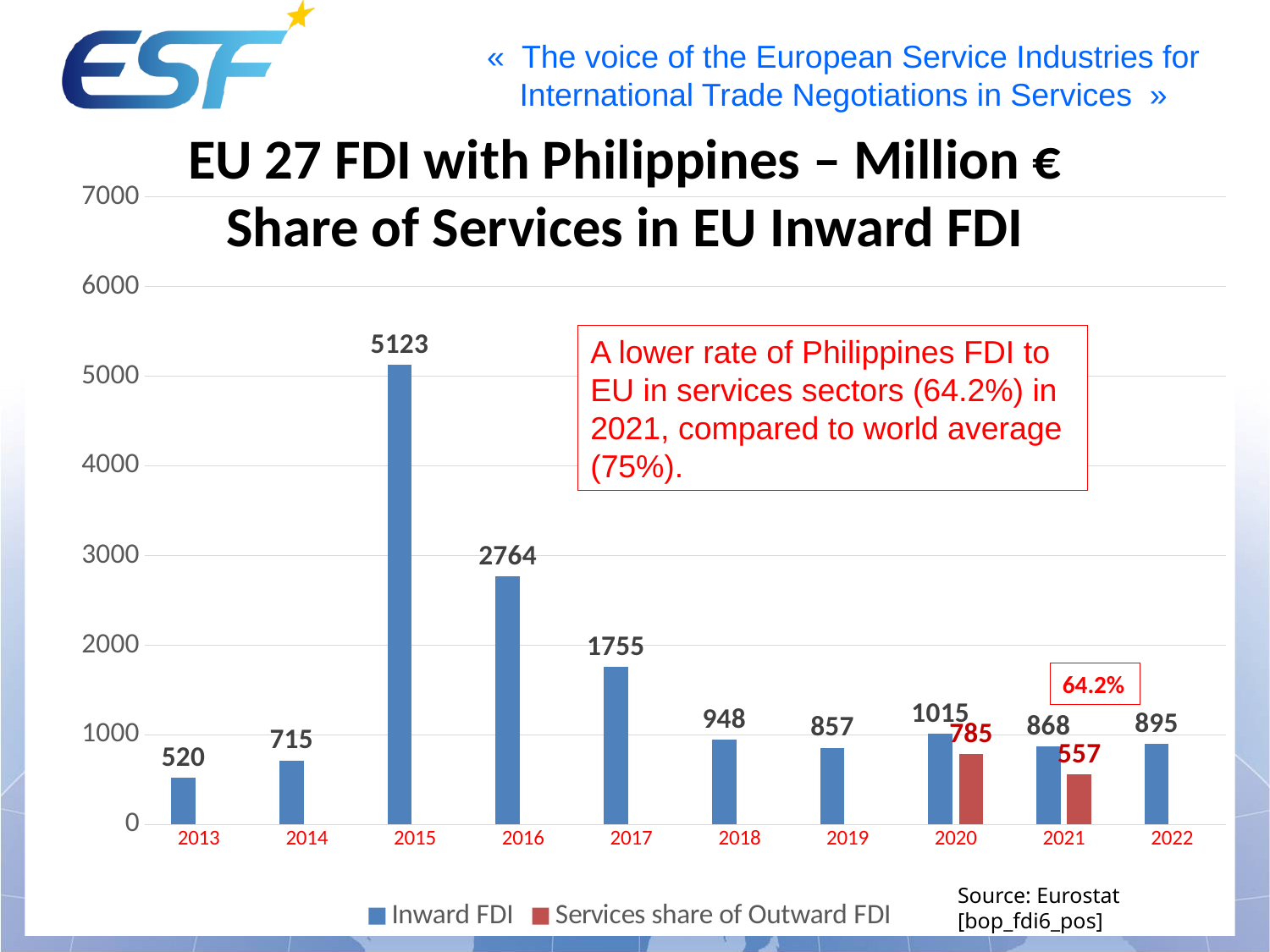
Is the Inward FDI value for 2017 greater or less than 2000? less Which year has the lowest Inward FDI value? 2013 How many years are shown on the x axis? 10 What is the Inward FDI value for 2013? 520 Which is larger, the Inward FDI value for 2020 or for 2022? 2020 How many series does the legend list? 2 What is the Services share of Outward FDI value for 2021? 557 What is the Inward FDI value for 2015? 5123 What is the Services share of Outward FDI value for 2020? 785 Which year has the highest Inward FDI value? 2015 What is the difference between the Inward FDI values for 2015 and 2016? 2359 What kind of chart is shown on the slide? bar chart